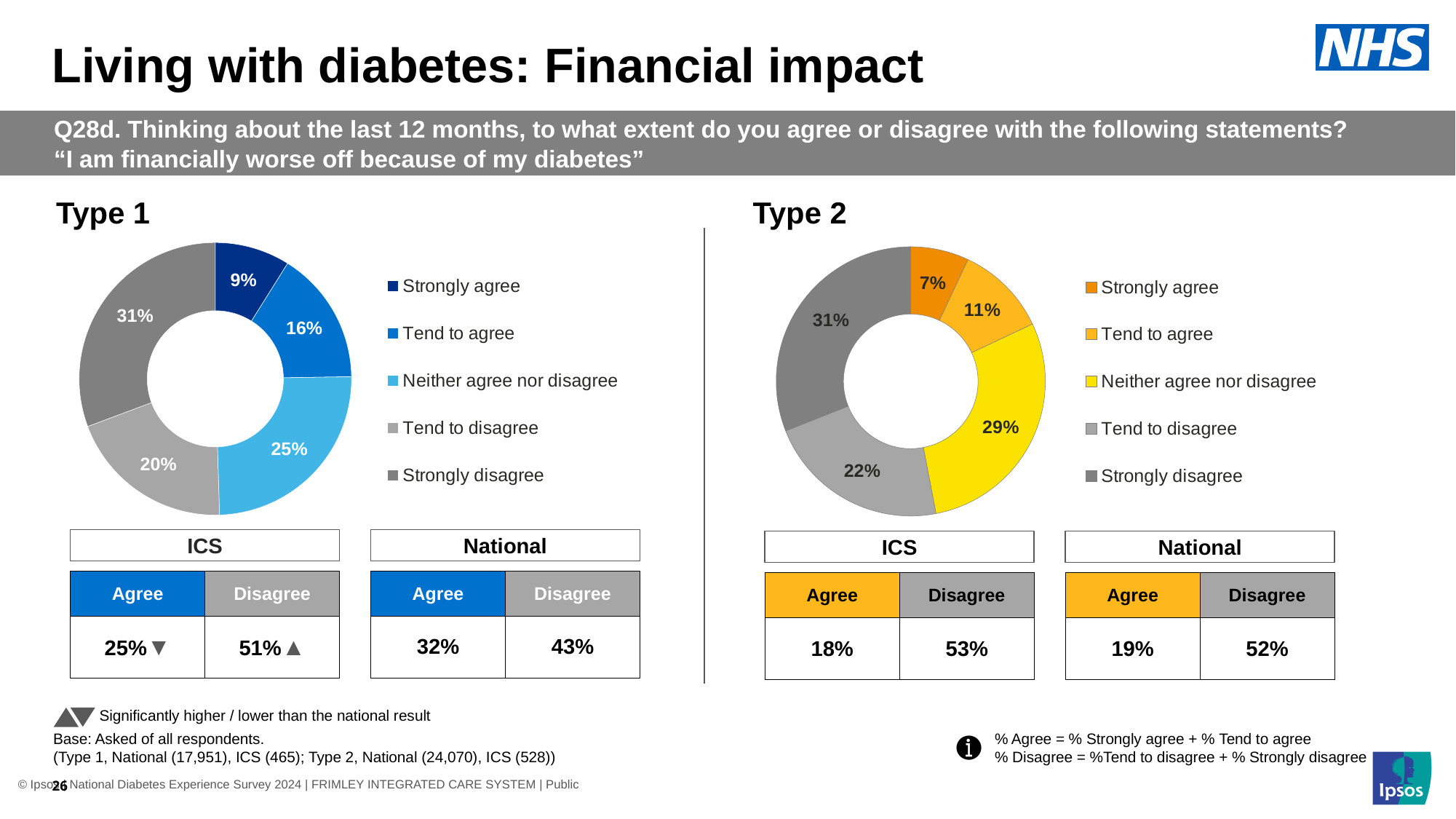
In the Type 2 chart, which response category has the smallest share? Strongly agree In the Type 2 chart, what percentage of respondents said 'Tend to agree'? 11% In the Type 1 chart, what percentage of respondents said 'Strongly agree'? 9% In the Type 1 chart, what percentage of respondents said 'Tend to disagree'? 20% In the Type 2 chart, which is larger: 'Tend to disagree' or 'Tend to agree'? Tend to disagree In the Type 1 chart, what colour is the 'Strongly disagree' segment? Dark grey In the Type 2 chart, what is the combined share of 'Strongly agree' and 'Tend to agree'? 18% How many response categories does the Type 1 chart show? 5 In the Type 2 chart, what percentage of respondents said 'Neither agree nor disagree'? 29% In the Type 1 chart, which response category has the largest share? Strongly disagree What kind of chart is used for the Type 2 data? Donut (pie) chart In the Type 1 chart, what is the difference between the 'Neither agree nor disagree' share and the 'Tend to agree' share? 9 percentage points